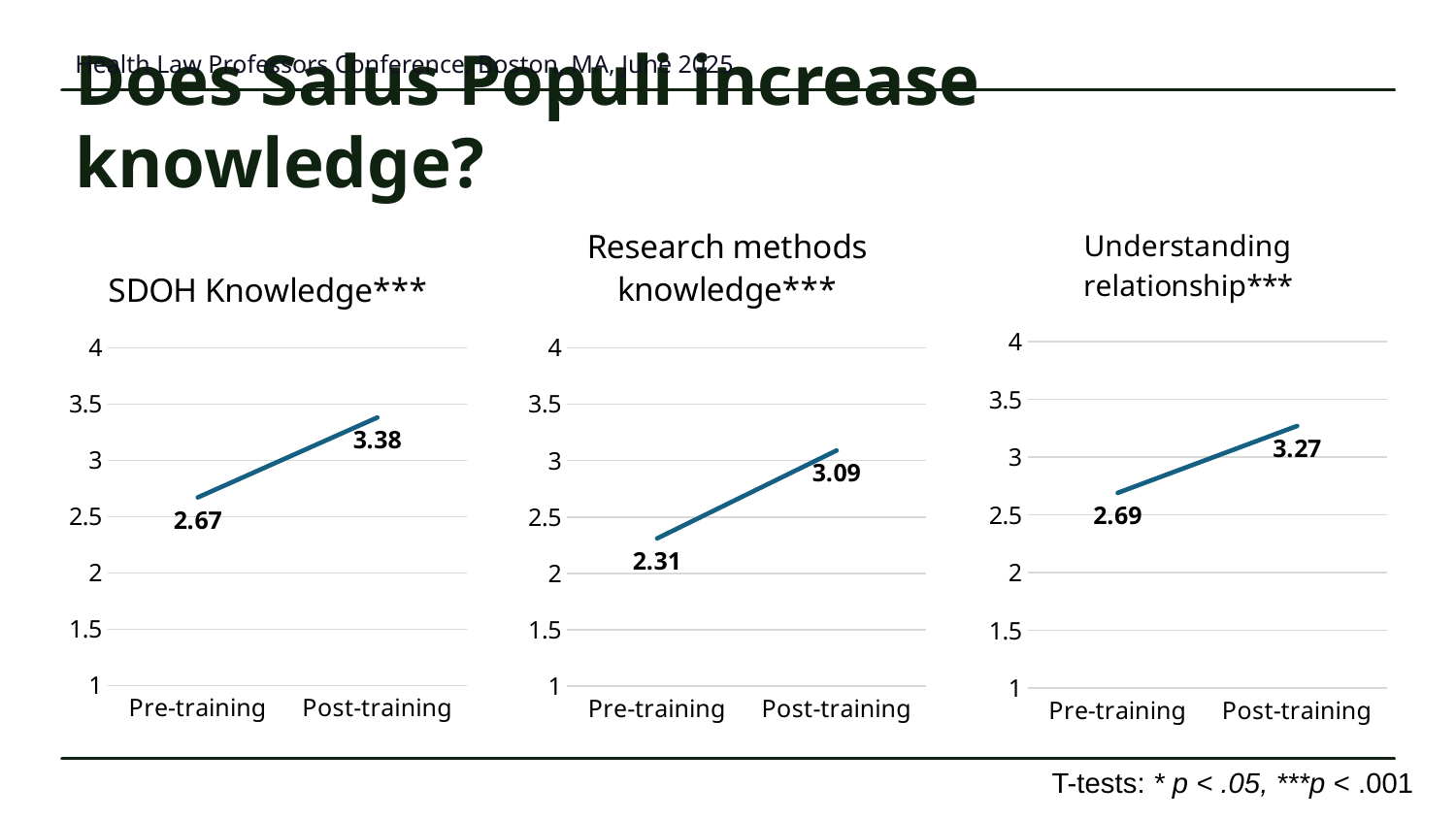
In the Research methods knowledge chart, do the values rise or fall from Pre-training to Post-training? rise In the SDOH Knowledge chart, what is the value for Post-training? 3.38 What kind of chart is the SDOH Knowledge chart? line chart In the Research methods knowledge chart, what is the value for Post-training? 3.09 In the SDOH Knowledge chart, what is the value for Pre-training? 2.67 In the Research methods knowledge chart, what is the value for Pre-training? 2.31 In the SDOH Knowledge chart, what is the difference between the Post-training and Pre-training values? 0.71 In the Understanding relationship chart, what is the value for Post-training? 3.27 In the Understanding relationship chart, is the Pre-training value greater or less than 3? less In the Research methods knowledge chart, what is the difference between the Post-training and Pre-training values? 0.78 In the Understanding relationship chart, which is larger, the Pre-training or the Post-training value? Post-training How many charts are shown on the slide? 3